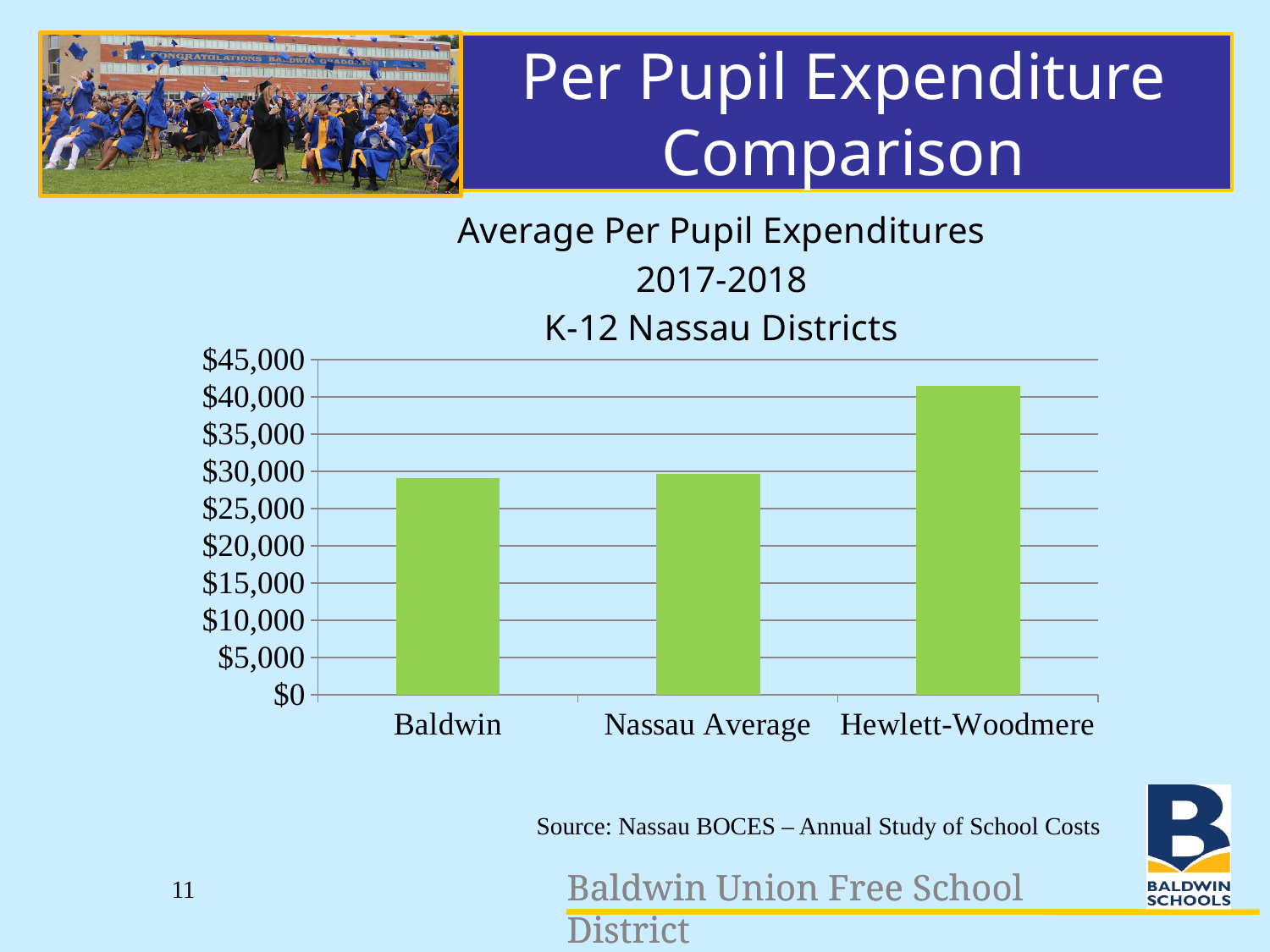
What is the source cited for the chart data? Nassau BOCES – Annual Study of School Costs Is the value for Hewlett-Woodmere greater or less than $40,000? greater What school year does the chart title say the data covers? 2017-2018 Is the value for Nassau Average greater or less than $25,000? greater How many districts/categories are plotted in the chart? 3 Is the value for Baldwin greater or less than $25,000? greater Which category has the highest average per pupil expenditure? Hewlett-Woodmere Which is larger, the value for Nassau Average or the value for Hewlett-Woodmere? Hewlett-Woodmere Which is larger, the value for Baldwin or the value for Hewlett-Woodmere? Hewlett-Woodmere What type of chart is shown on the slide? bar chart